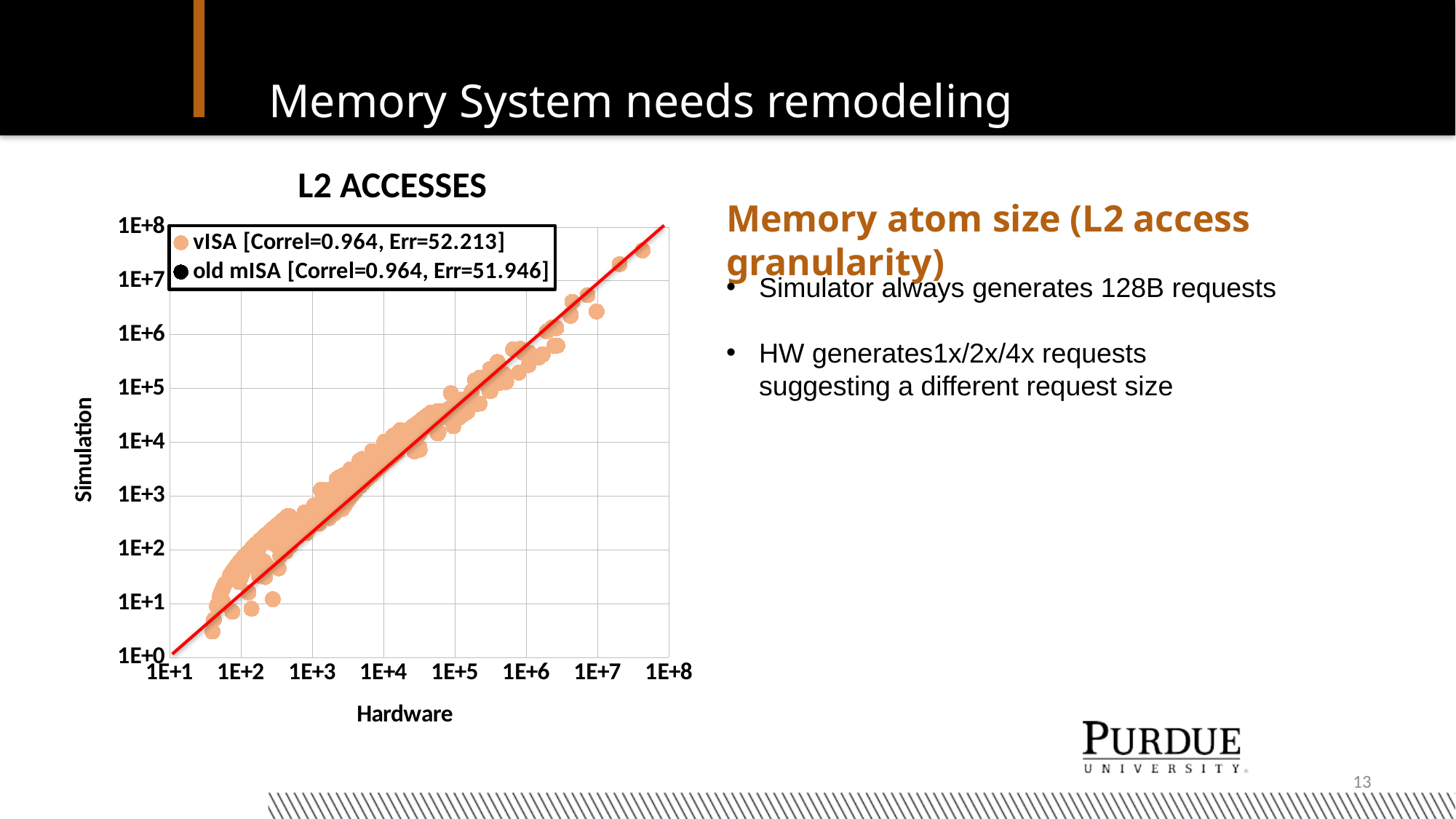
How many series does the legend of the L2 ACCESSES chart list? 2 What kind of chart is shown under the title L2 ACCESSES? scatter chart In the L2 ACCESSES chart, do the Simulation values rise or fall as the Hardware values increase? rise According to the legend of the L2 ACCESSES chart, what is the difference between the Err values of vISA and old mISA? 0.267 What is the title of the chart on the slide? L2 ACCESSES What is the label of the x axis of the L2 ACCESSES chart? Hardware What Err value does the legend of the L2 ACCESSES chart give for old mISA? 51.946 According to the legend of the L2 ACCESSES chart, which series has the larger Err value, vISA or old mISA? vISA What Err value does the legend of the L2 ACCESSES chart give for vISA? 52.213 What Correl value does the legend of the L2 ACCESSES chart give for vISA? 0.964